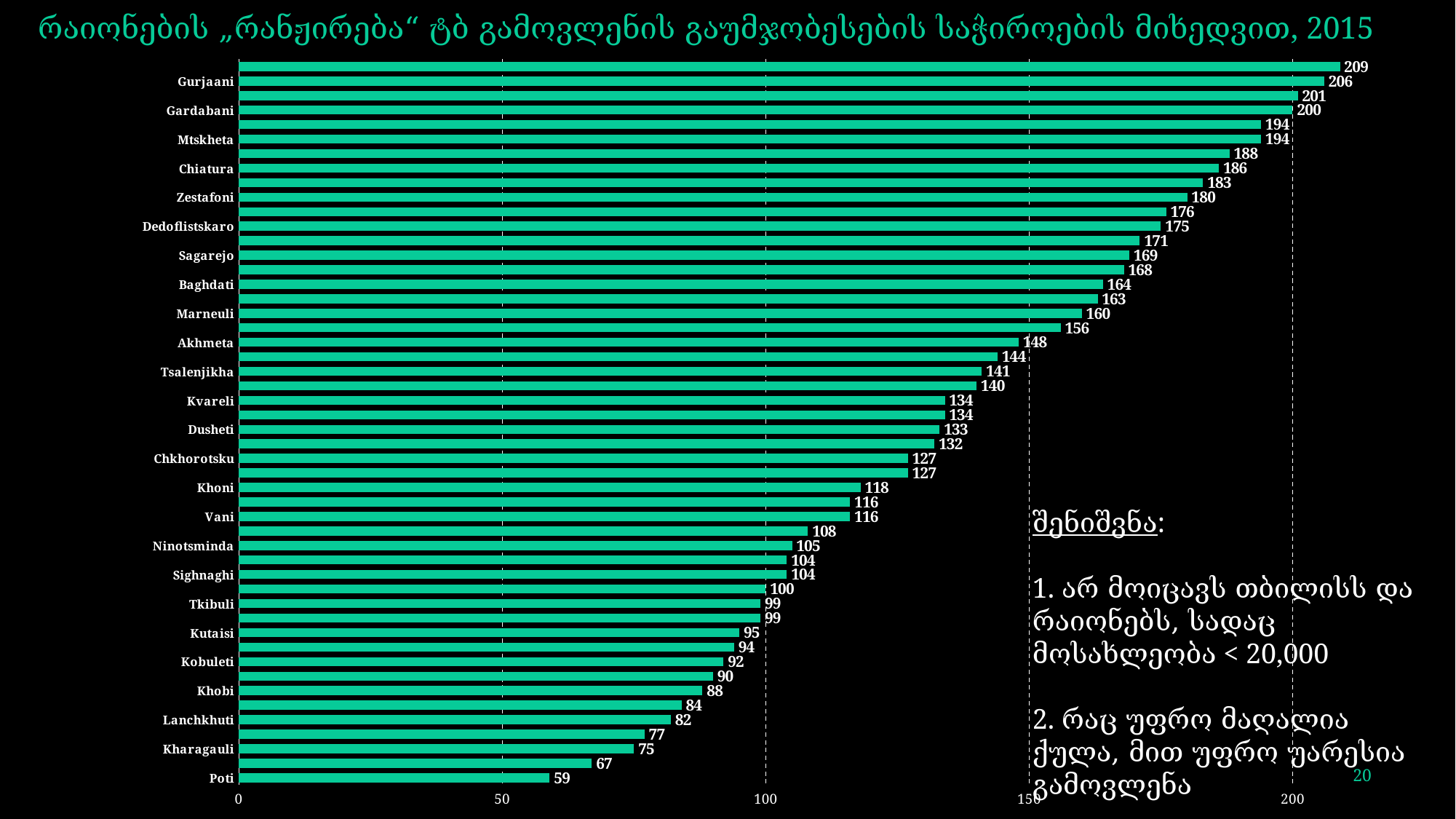
What is the value for Akhmeta? 148 What is the value for Poti? 59 What is the difference between the values for Kharagauli and Poti? 16 Which labelled district has the lowest value? Poti What is the value for Kharagauli? 75 What kind of chart is shown on the slide? bar chart Which has a larger value, Kutaisi or Khobi? Kutaisi Do the bar values rise or fall going from the top of the chart to the bottom? fall What is the value for Khobi? 88 Is the value for Poti greater or less than 100? less What is the highest value shown on the chart? 209 What is the value for Chiatura? 186